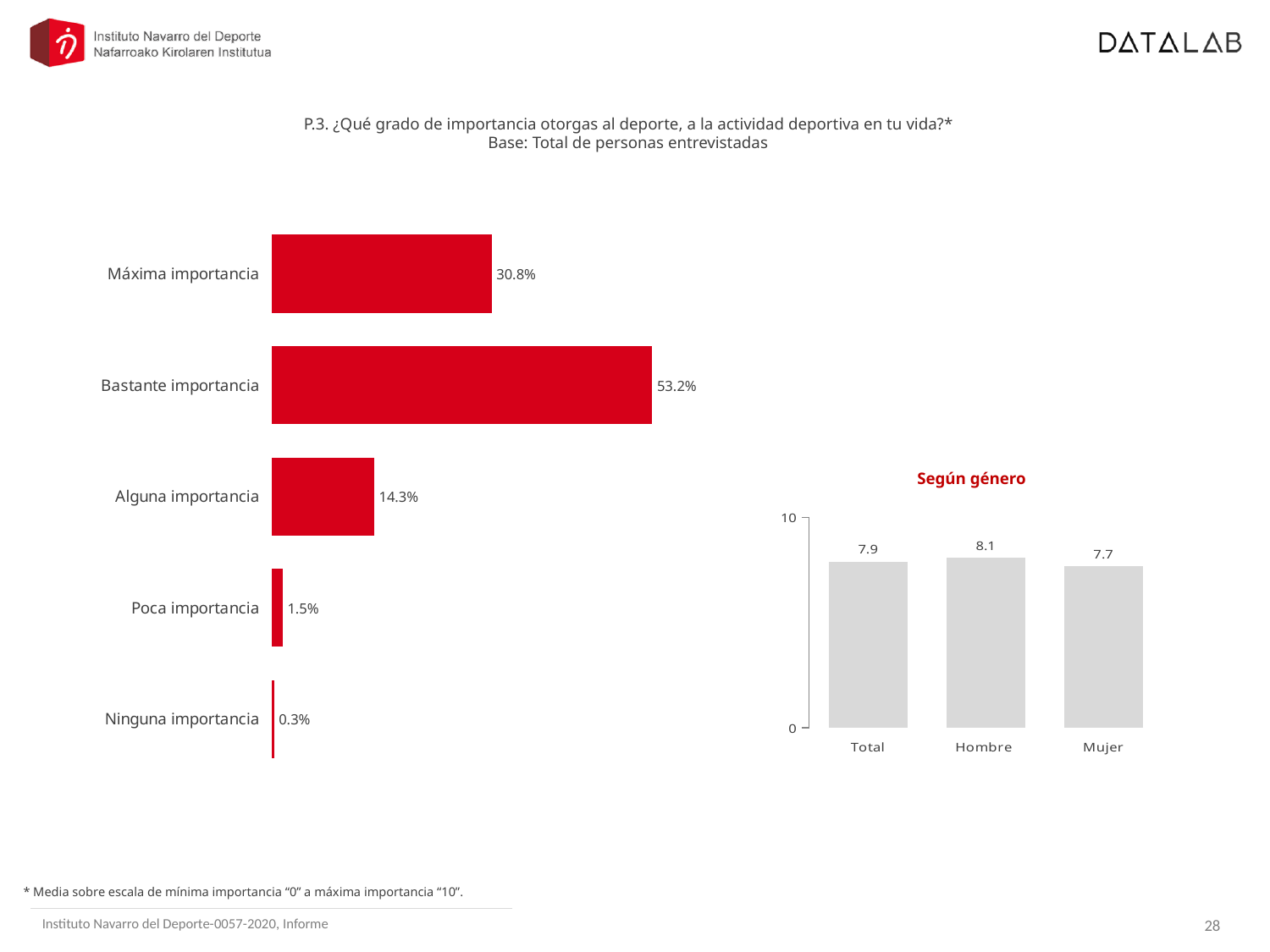
In the 'Según género' chart, what is the value for Hombre? 8.1 How many categories does the left chart show? 5 In the left chart, which category has the lowest percentage? Ninguna importancia What is the title of the chart on the right? Según género What type of chart is the left chart? Bar chart In the 'Según género' chart, which category has the lowest value? Mujer In the left chart, which is larger: Alguna importancia or Poca importancia? Alguna importancia In the left chart, what percentage is shown for Bastante importancia? 53.2% In the left chart, which category has the highest percentage? Bastante importancia In the 'Según género' chart, what is the difference between Hombre and Mujer? 0.4 In the left chart, what percentage is shown for Ninguna importancia? 0.3% In the left chart, what is the difference between Bastante importancia and Máxima importancia? 22.4%